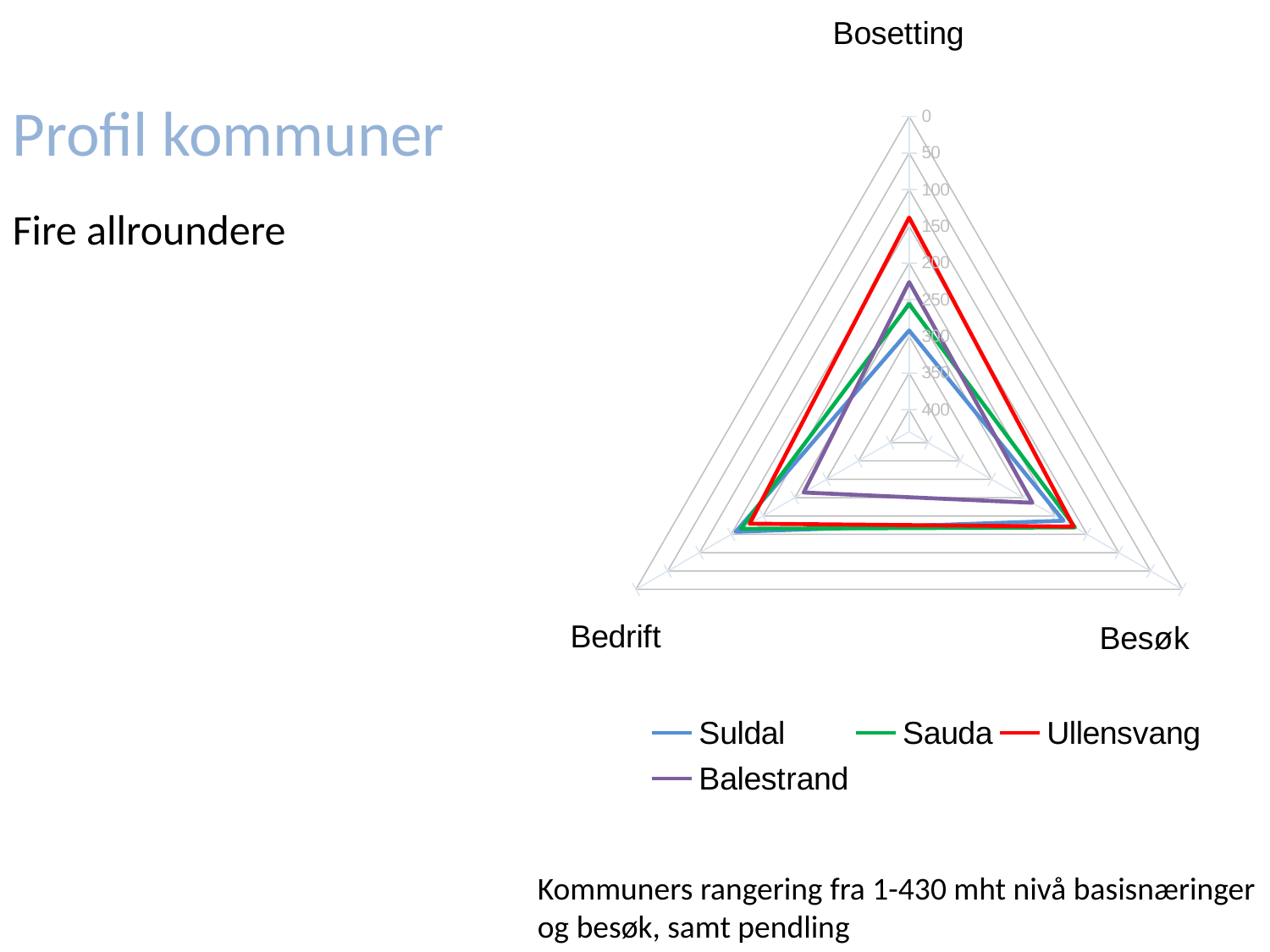
Which series is drawn in red? Ullensvang What are the three axis labels on the radar chart? Bosetting, Bedrift, Besøk On the Besøk axis, which is larger: the value for Balestrand or the value for Ullensvang? Balestrand Is the value for Balestrand on the Bosetting axis greater or less than 150? greater How many series does the legend list? 4 Is the value for Ullensvang on the Besøk axis greater or less than 200? less Which series has the smallest value on the Bosetting axis? Ullensvang Is the value for Suldal on the Bosetting axis greater or less than 250? greater How many axes (categories) does the radar chart have? 3 What kind of chart is shown on the slide? Radar chart